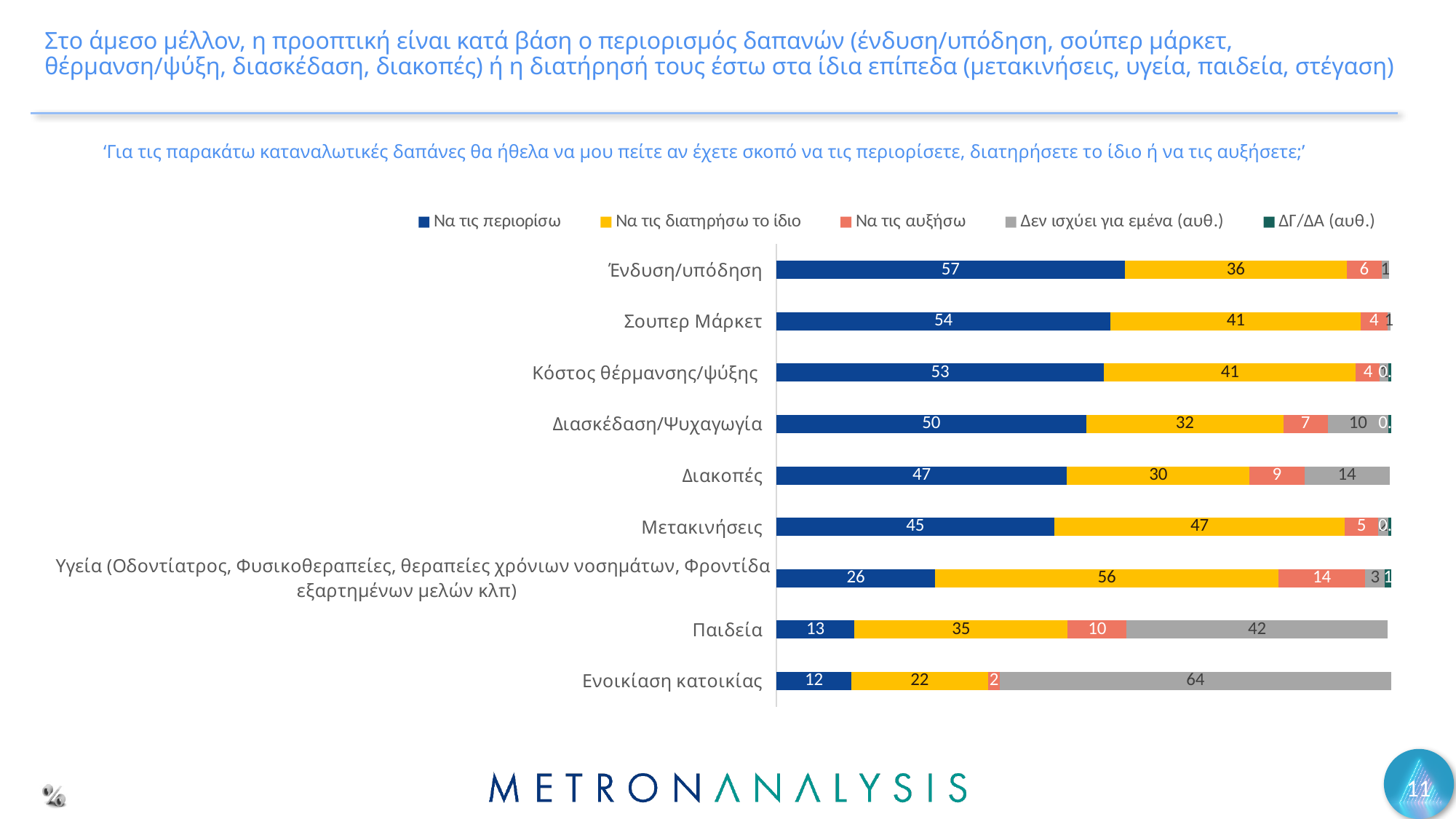
What is the value of 'Δεν ισχύει για εμένα (αυθ.)' for Ενοικίαση κατοικίας? 64 What colour represents 'Να τις αυξήσω' in the chart? Orange/salmon How many series does the legend list? 5 Which category has the highest value for 'Να τις περιορίσω'? Ένδυση/υπόδηση What is the total of the stacked bar for Παιδεία? 100 What is the difference between the 'Να τις περιορίσω' values for Σουπερ Μάρκετ and Διακοπές? 7 What is the value of 'Να τις περιορίσω' for Ένδυση/υπόδηση? 57 How many categories (expense types) are shown in the chart? 9 What type of chart is shown on the slide? Stacked bar chart Which category has the lowest value for 'Να τις περιορίσω'? Ενοικίαση κατοικίας Which is larger for Μετακινήσεις: 'Να τις περιορίσω' or 'Να τις διατηρήσω το ίδιο'? Να τις διατηρήσω το ίδιο What is the value of 'Να τις διατηρήσω το ίδιο' for Υγεία (Οδοντίατρος, Φυσικοθεραπείες, θεραπείες χρόνιων νοσημάτων, Φροντίδα εξαρτημένων μελών κλπ)? 56